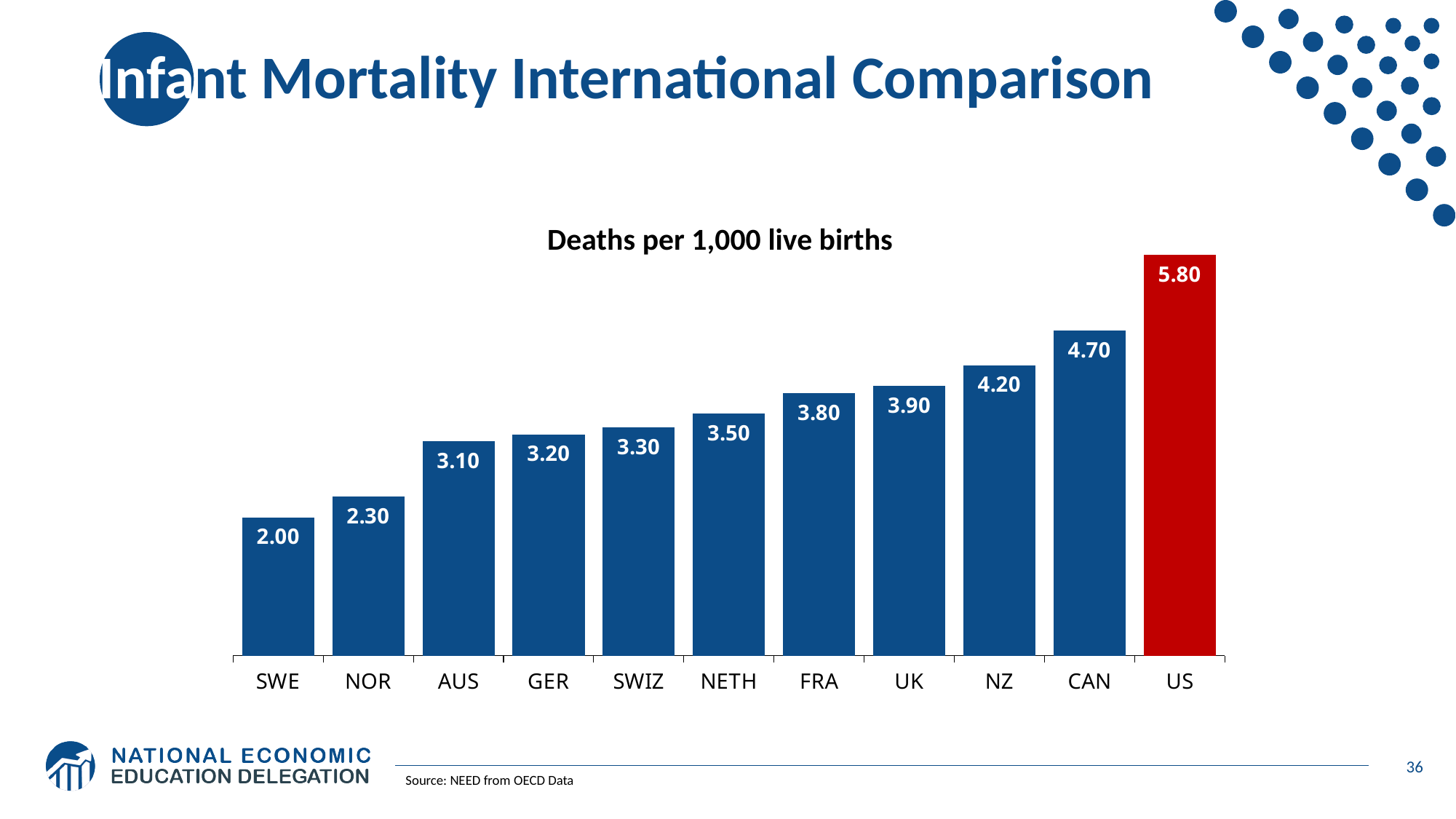
What is the value for the US? 5.80 Which is larger, the value for NETH or the value for NOR? NETH How many countries are shown in the chart? 11 What is the difference between the values for FRA and SWE? 1.80 What is the difference between the values for the US and CAN? 1.10 What is the value for GER? 3.20 Which country has the lowest value? SWE Which country has the highest value? US Do the values rise or fall from left to right along the x axis? Rise What kind of chart is this? Bar chart What is the value for NZ? 4.20 Which bar is coloured red rather than blue? US